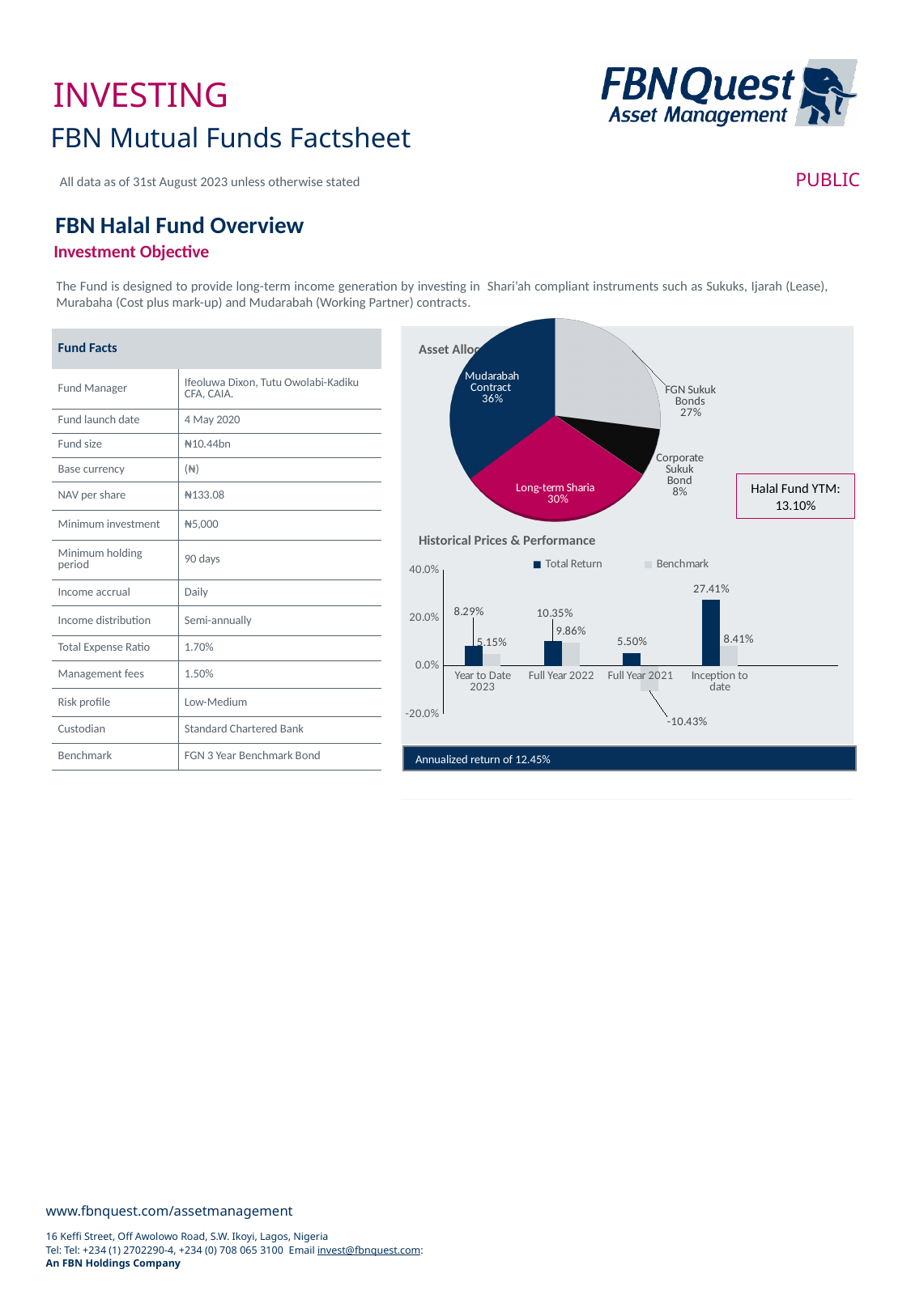
In the Historical Prices & Performance chart, how many series does the legend list? 2 In the asset allocation pie chart, how many slices are there? 4 In the Historical Prices & Performance chart, what is the Benchmark value for Full Year 2021? -10.43% In the asset allocation pie chart, what share is Mudarabah Contract? 36% In the asset allocation pie chart, what is the difference between the FGN Sukuk Bonds share and the Corporate Sukuk Bond share? 19% In the Historical Prices & Performance chart, which period has the lowest Benchmark value? Full Year 2021 What kind of chart is the Historical Prices & Performance chart? Bar chart In the asset allocation pie chart, which slice is the largest? Mudarabah Contract In the Historical Prices & Performance chart, what is the Total Return for Inception to date? 27.41% In the asset allocation pie chart, which slice is the smallest? Corporate Sukuk Bond In the Historical Prices & Performance chart, which is larger for Full Year 2022, Total Return or Benchmark? Total Return In the Historical Prices & Performance chart, what is the difference between Total Return and Benchmark for Year to Date 2023? 3.14%